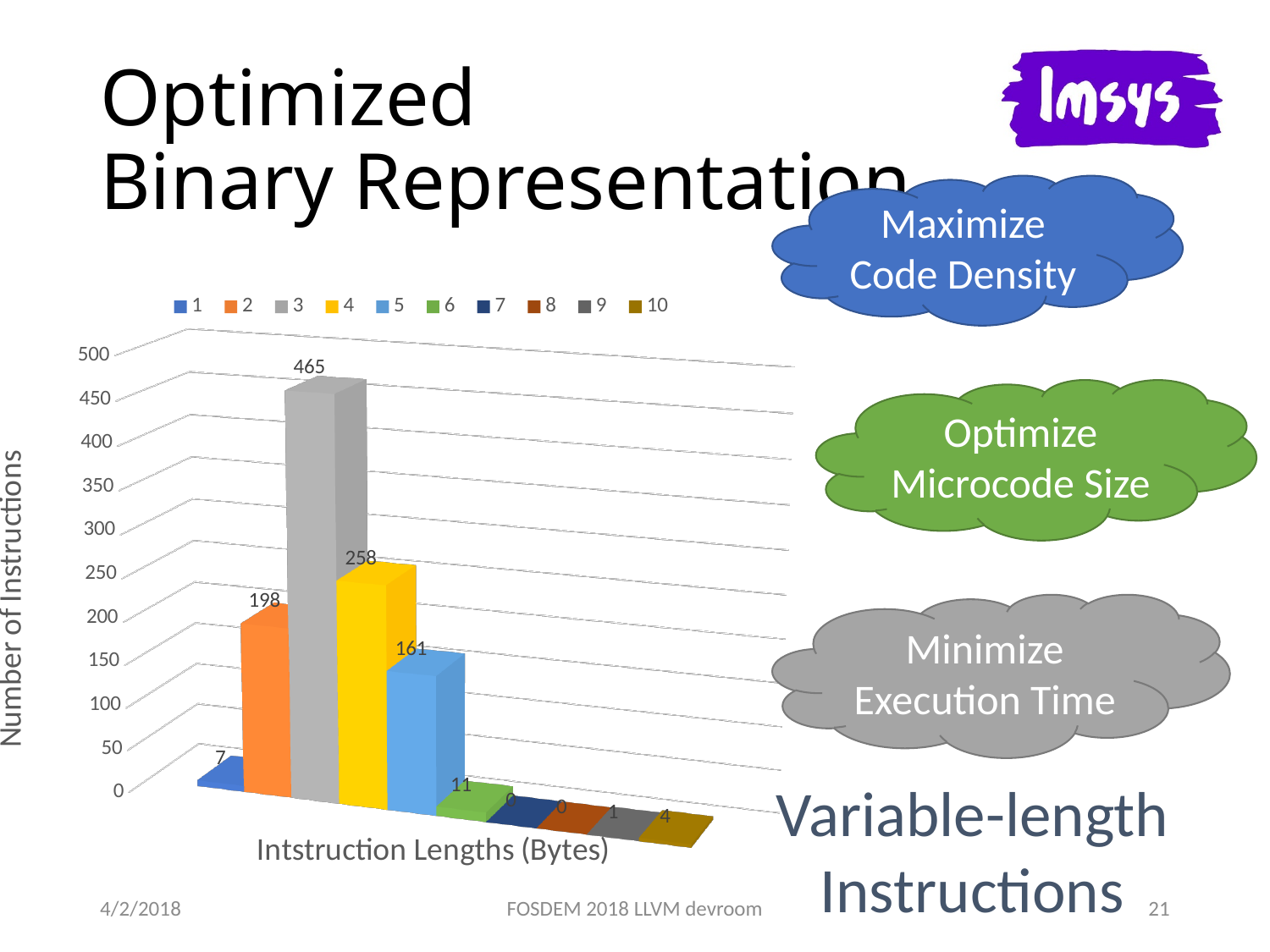
How many series does the legend list? 10 What is the number of instructions for instruction length 5 bytes? 161 What is the difference in number of instructions between instruction lengths 2 and 5? 37 What is the number of instructions for instruction length 10 bytes? 4 What kind of chart is shown on the slide? bar chart What is the number of instructions for instruction length 3 bytes? 465 What is the number of instructions for instruction length 2 bytes? 198 Which has more instructions, instruction length 4 or instruction length 2? 4 What is the label of the vertical axis of the chart? Number of Instructions What is the difference in number of instructions between instruction lengths 3 and 4? 207 What is the label of the horizontal axis of the chart? Intstruction Lengths (Bytes) Which instruction length has the highest number of instructions? 3